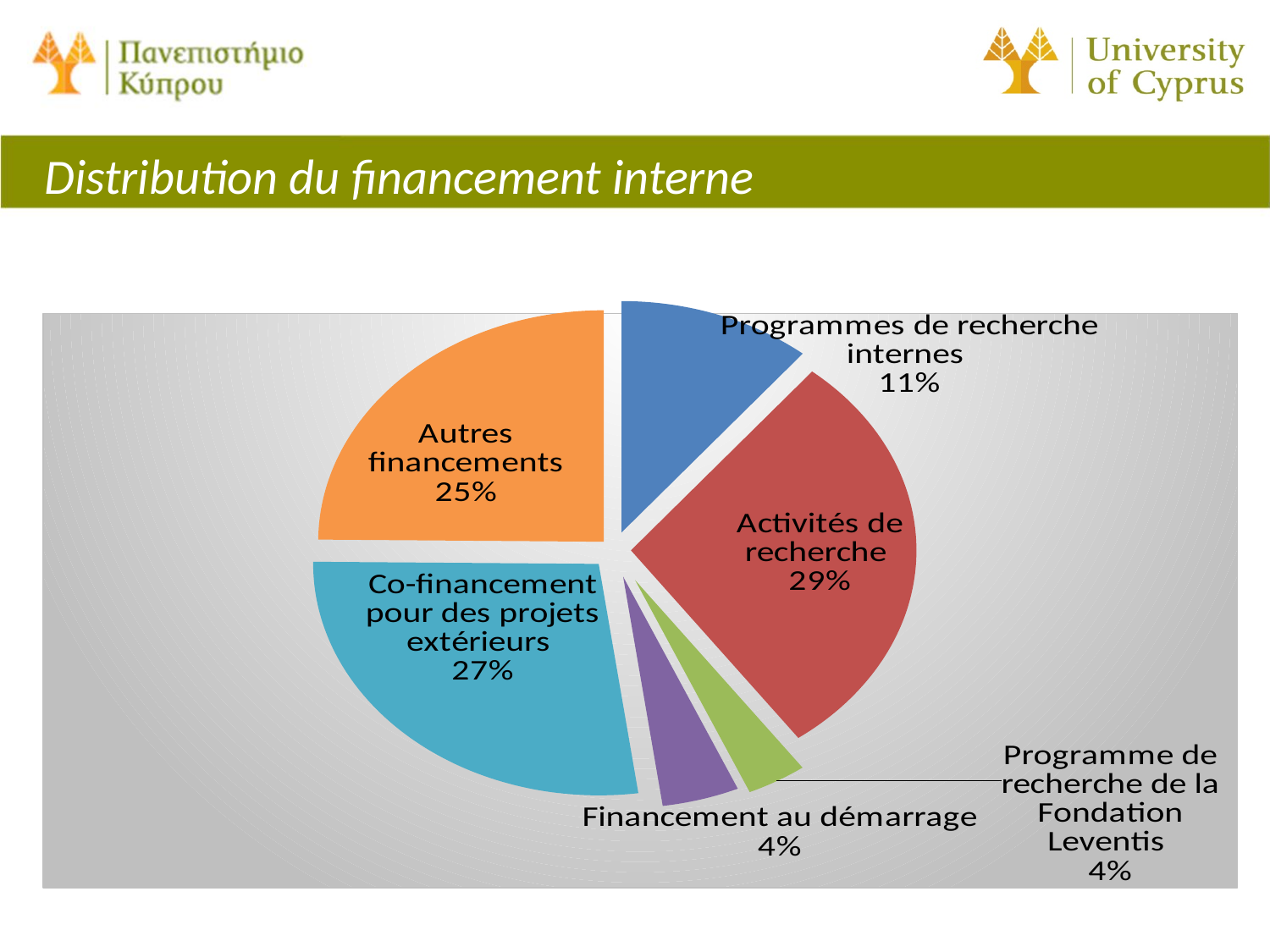
What is the title of the chart on the slide? Distribution du financement interne What percentage is shown for 'Programme de recherche de la Fondation Leventis'? 4% What kind of chart is shown on the slide? Pie chart What percentage is shown for 'Co-financement pour des projets extérieurs'? 27% Which category has the largest share of the pie? Activités de recherche How many slices does the pie chart have? 6 What percentage is shown for 'Programmes de recherche internes'? 11% What is the difference in percentage points between 'Activités de recherche' and 'Programmes de recherche internes'? 18 percentage points Which is larger: 'Co-financement pour des projets extérieurs' or 'Autres financements'? Co-financement pour des projets extérieurs What share of the pie is 'Activités de recherche'? 29% What percentage is shown for 'Autres financements'? 25% What colour is the slice for 'Financement au démarrage'? Purple